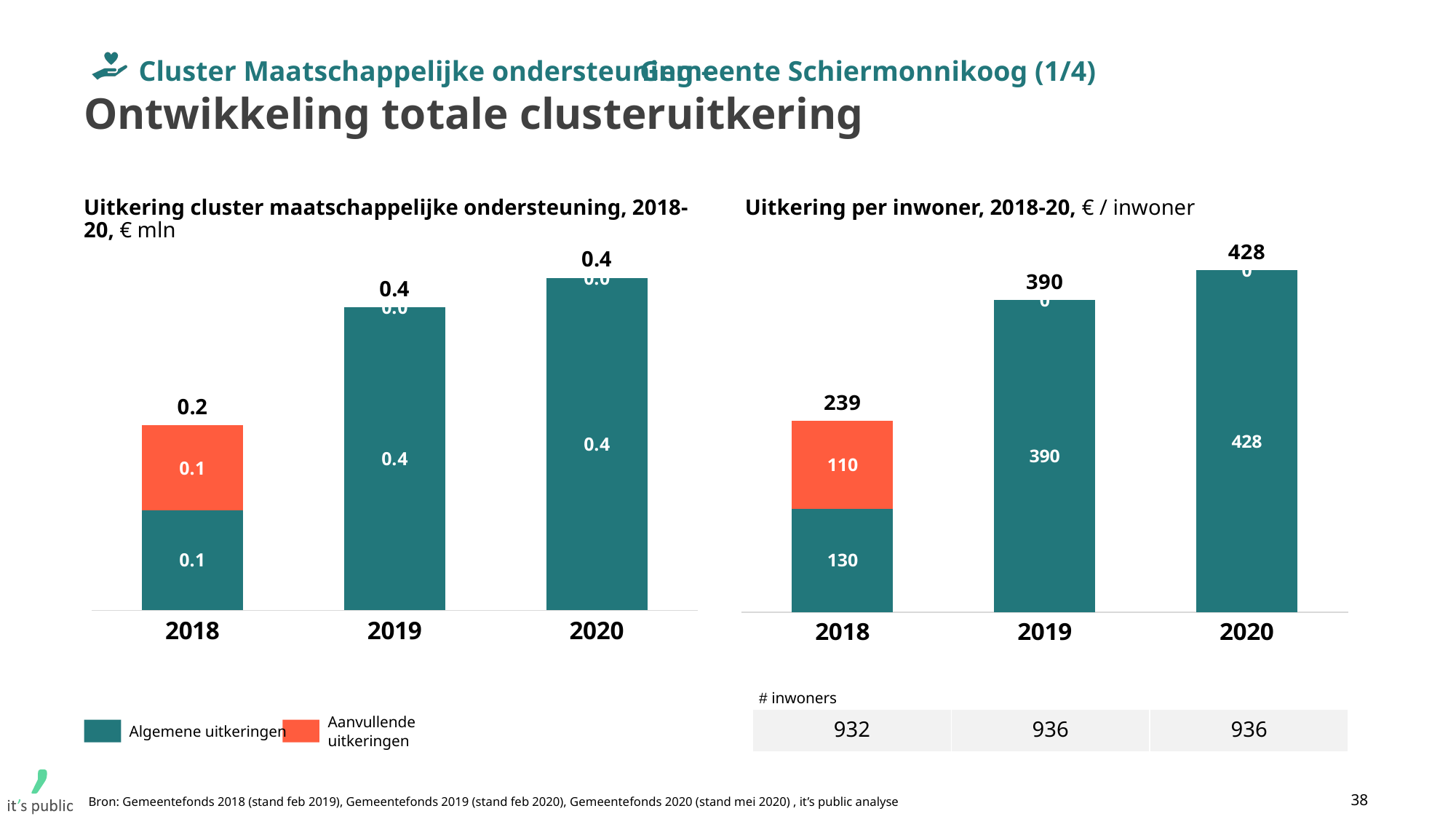
In the chart 'Uitkering per inwoner, 2018-20', which year has the lowest total? 2018 In the chart 'Uitkering per inwoner, 2018-20', what is the value of Algemene uitkeringen for 2018? 130 What type of chart is 'Uitkering cluster maatschappelijke ondersteuning, 2018-20'? stacked bar chart In the chart 'Uitkering per inwoner, 2018-20', what is the total value for 2020? 428 In the chart 'Uitkering per inwoner, 2018-20', what is the difference between the totals for 2020 and 2019? 38 In the chart 'Uitkering per inwoner, 2018-20', what is the difference between the totals for 2019 and 2018? 151 In the chart 'Uitkering cluster maatschappelijke ondersteuning, 2018-20', what is the total value for 2018? 0.2 In the chart 'Uitkering per inwoner, 2018-20', what is the value of Aanvullende uitkeringen for 2018? 110 In the chart 'Uitkering cluster maatschappelijke ondersteuning, 2018-20', is the total for 2018 larger or smaller than the total for 2020? smaller In the chart 'Uitkering cluster maatschappelijke ondersteuning, 2018-20', what is the value of Algemene uitkeringen for 2019? 0.4 How many years are shown on the x axis of the chart 'Uitkering per inwoner, 2018-20'? 3 In the chart 'Uitkering per inwoner, 2018-20', which year has the highest total? 2020